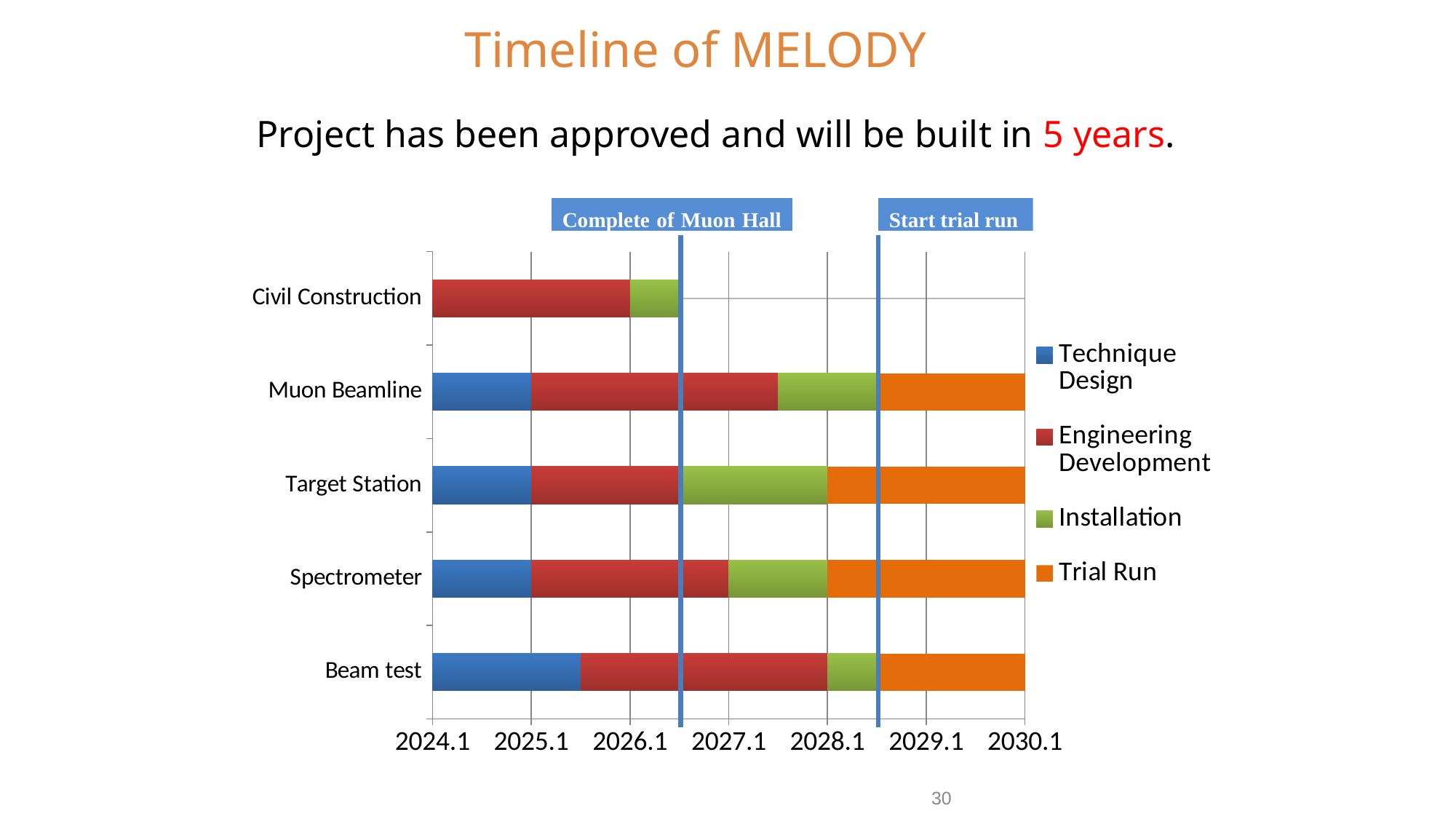
How many series does the legend list? 4 Which category has the longest Installation segment? Target Station Which category has the shortest overall bar on the chart? Civil Construction How many categories (rows) are plotted on the chart? 5 At which axis tick does the Technique Design segment for Muon Beamline end? 2025.1 At which axis tick does the Engineering Development segment for Spectrometer end? 2027.1 At which axis tick does the Trial Run segment for Target Station end? 2030.1 What does the legend label the orange series? Trial Run Which category has no Trial Run segment? Civil Construction Which category has the longest Technique Design segment? Beam test What kind of chart is shown on the slide? Stacked horizontal bar chart (Gantt-style) Is the Installation segment for Target Station longer or shorter than the Installation segment for Beam test? longer